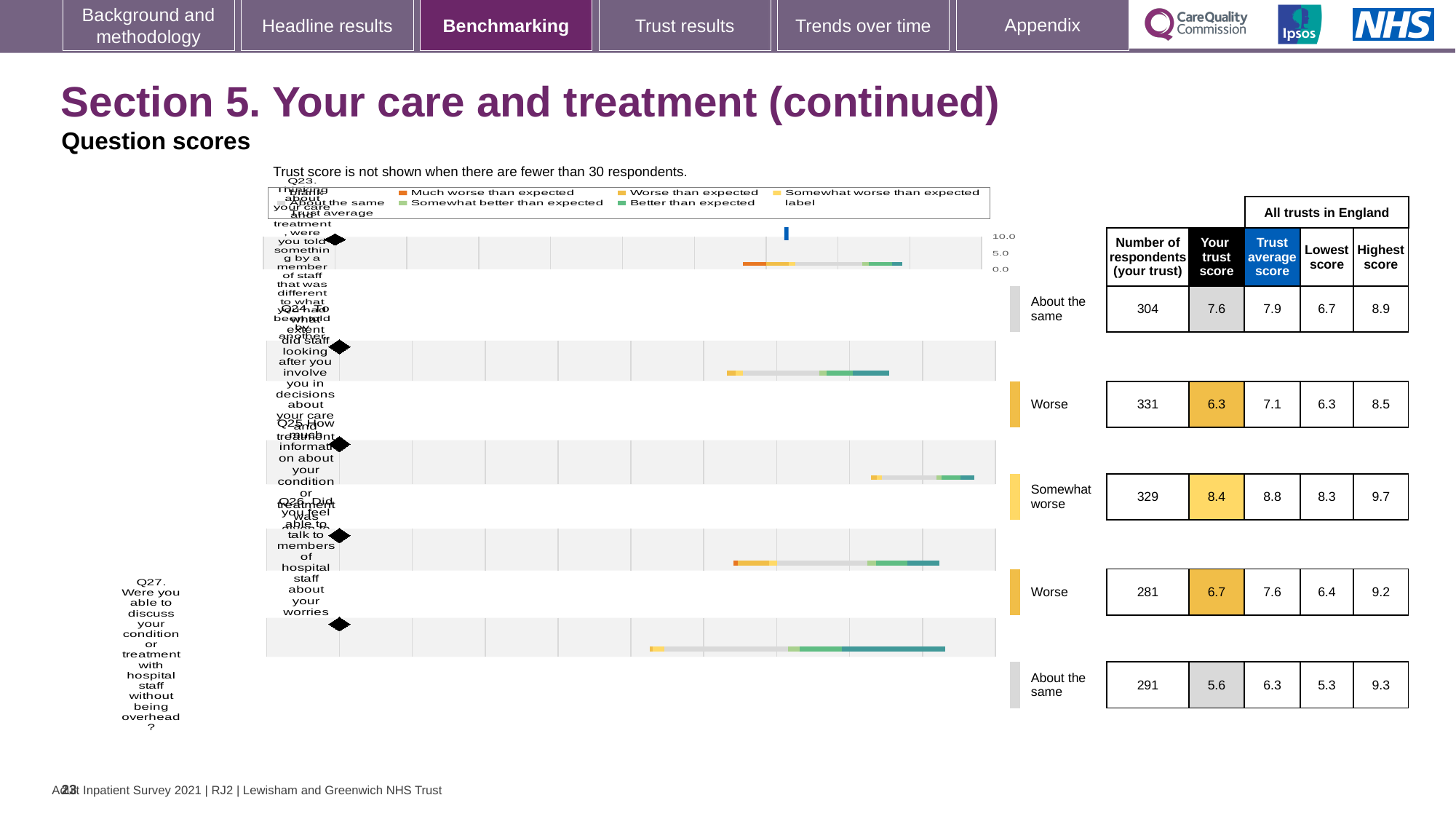
What benchmark rating is shown for Q24? Worse What is the trust average score for Q25 (information about your condition or treatment)? 8.8 What is the trust score for Q27 (discussing your condition without being overheard)? 5.6 How many questions are plotted on the chart? 5 How many respondents answered Q24 (staff involving you in decisions about your care)? 331 What is the highest score across all trusts in England for Q26 (talking to hospital staff about your worries)? 9.2 Which has the larger trust score, Q23 or Q24? Q23 What is the trust score for Q23 (being told something different by a member of staff)? 7.6 Which question has the lowest trust score? Q27 What is the difference between the trust average score and the trust score for Q25? 0.4 Which question has the highest trust score? Q25 What kind of chart is used to show the question scores? Bar chart